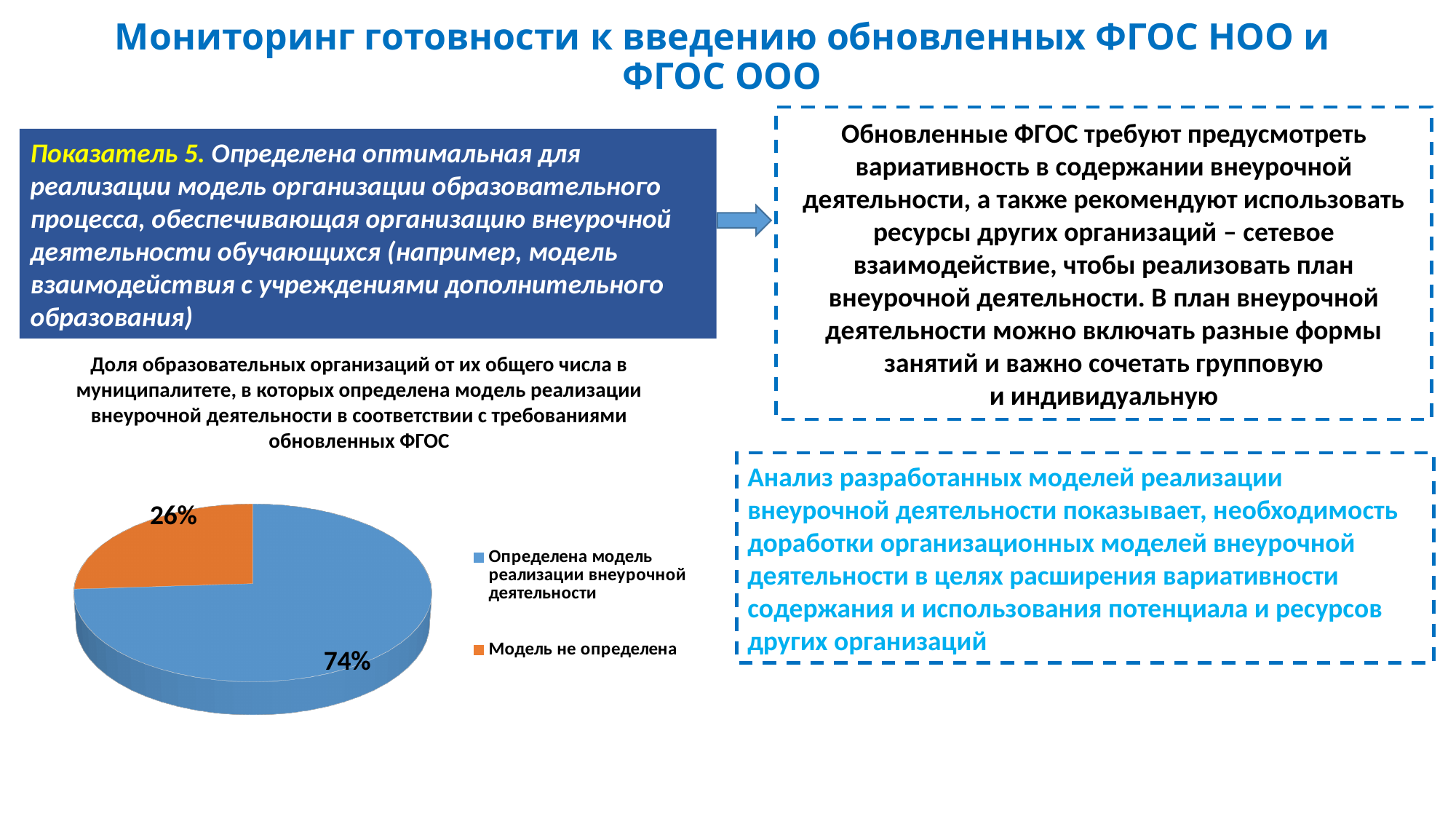
What colour is the 'Модель не определена' slice in the pie chart? orange What is the difference in percentage points between the 'Определена модель реализации внеурочной деятельности' slice and the 'Модель не определена' slice? 48 What share of the pie does 'Определена модель реализации внеурочной деятельности' take? 74% What share of the pie does 'Модель не определена' take? 26% How many entries does the legend of the pie chart list? 2 How many slices does the pie chart have? 2 What kind of chart is shown on the slide? pie chart Which is larger: the share for 'Определена модель реализации внеурочной деятельности' or for 'Модель не определена'? Определена модель реализации внеурочной деятельности What colour is the 'Определена модель реализации внеурочной деятельности' slice in the pie chart? blue Which slice of the pie is the largest? Определена модель реализации внеурочной деятельности Which slice of the pie is the smallest? Модель не определена